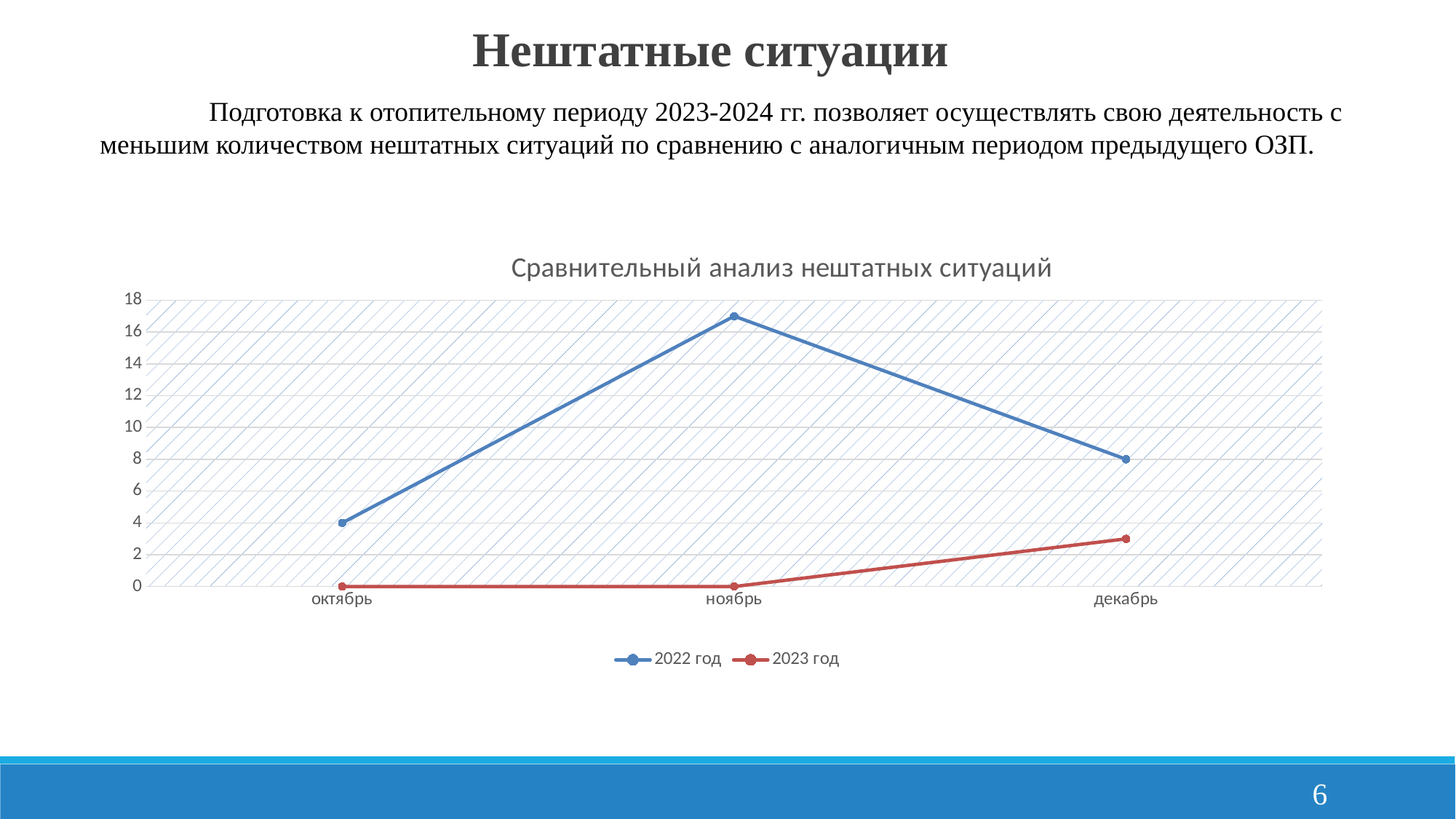
What is the value for 2022 год in декабрь? 8 Is the value for 2023 год in декабрь greater or less than 4? less What is the value for 2023 год in ноябрь? 0 How many series does the legend list? 2 What is the value for 2022 год in октябрь? 4 Is the value for 2022 год in ноябрь greater or less than 16? greater What is the title of the chart? Сравнительный анализ нештатных ситуаций What is the difference between the 2022 год values for декабрь and октябрь? 4 In which month is the value for 2022 год highest? ноябрь What type of chart is shown on the slide? line chart Which series has the larger value in ноябрь, 2022 год or 2023 год? 2022 год How many categories are shown on the x axis? 3